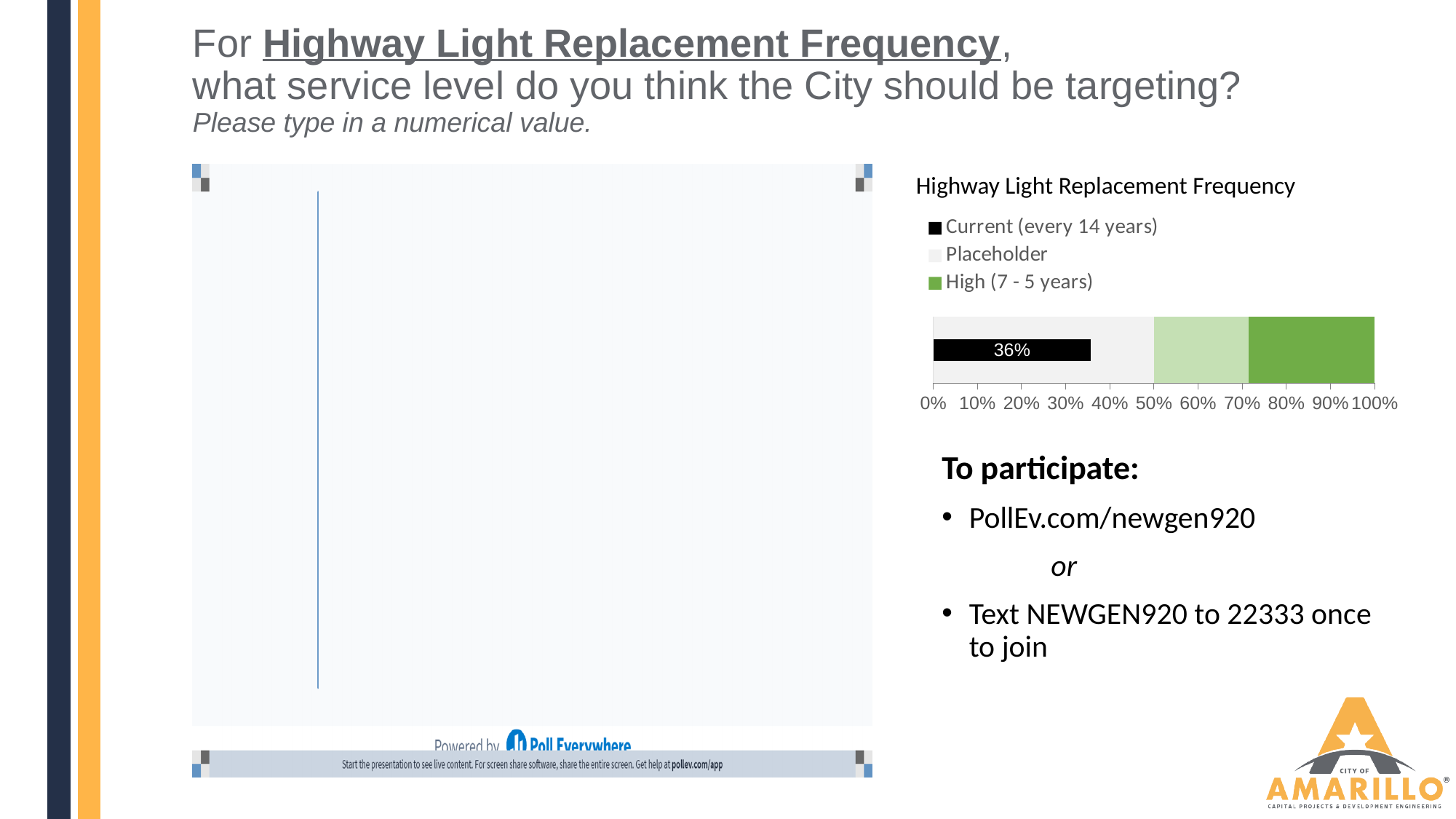
How many data bars with a printed value are plotted in the Highway Light Replacement Frequency chart? 1 Is the value shown on the black bar in the Highway Light Replacement Frequency chart greater or less than 40%? less In the Highway Light Replacement Frequency chart, which legend entry is shown in green? High (7 - 5 years) Is the value shown on the black bar in the Highway Light Replacement Frequency chart greater or less than 30%? greater What is the title of the chart on the slide? Highway Light Replacement Frequency What is the highest value shown on the x axis of the Highway Light Replacement Frequency chart? 100% How many series does the legend of the Highway Light Replacement Frequency chart list? 3 Is the value shown on the black bar in the Highway Light Replacement Frequency chart greater or less than 50%? less What kind of chart is the Highway Light Replacement Frequency chart? bar chart What value is printed on the black bar in the Highway Light Replacement Frequency chart? 36%